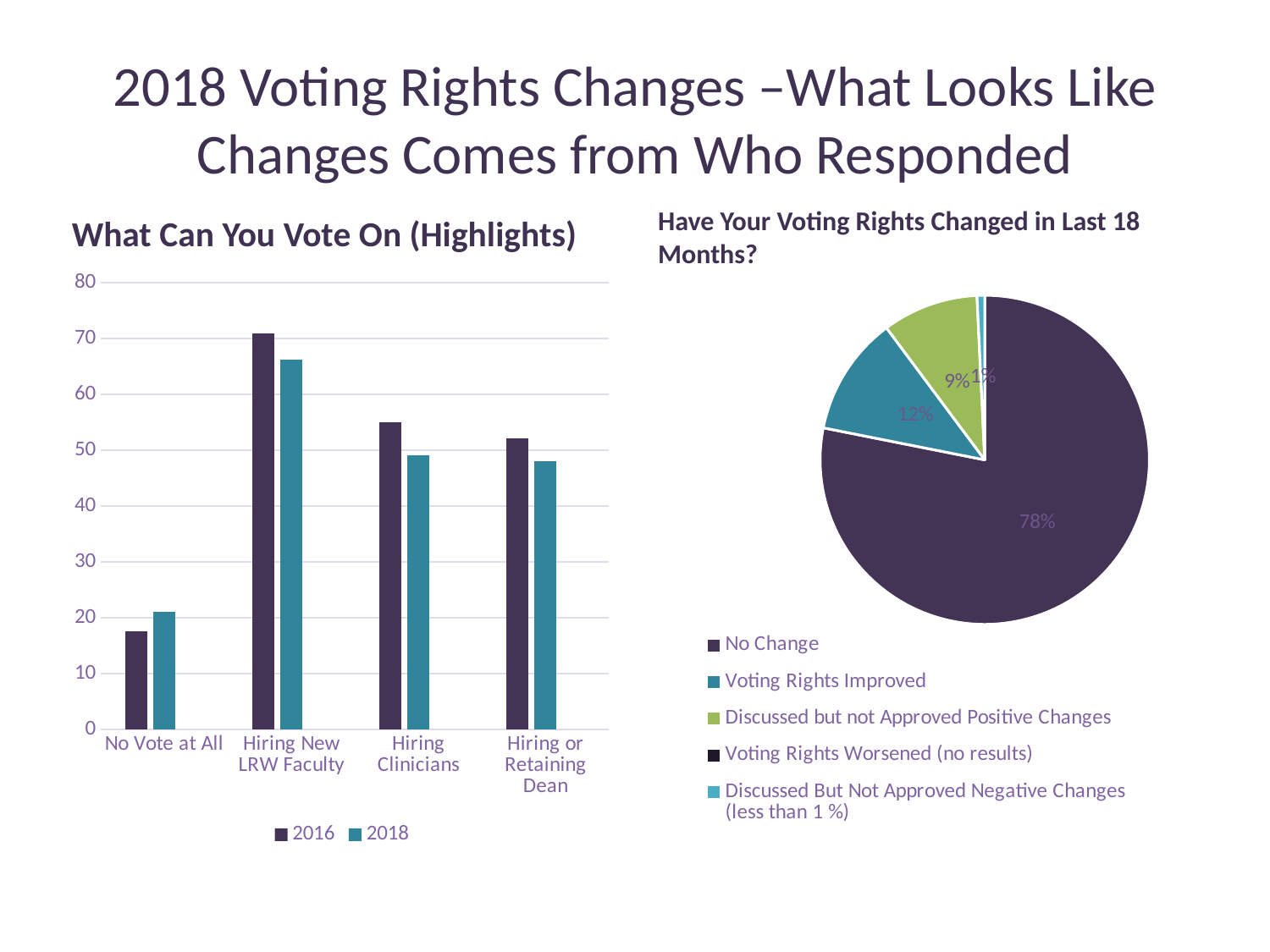
In the 'What Can You Vote On (Highlights)' chart, which category has the highest 2016 value? Hiring New LRW Faculty In the 'What Can You Vote On (Highlights)' chart, how many categories are shown on the x axis? 4 In the 'What Can You Vote On (Highlights)' chart, how many series does the legend list? 2 In the 'Have Your Voting Rights Changed in Last 18 Months?' chart, what share of the pie is Discussed but not Approved Positive Changes? 9% In the 'What Can You Vote On (Highlights)' chart, is the 2016 value for No Vote at All greater or less than 20? less In the 'What Can You Vote On (Highlights)' chart, which is larger for Hiring New LRW Faculty, the 2016 value or the 2018 value? 2016 In the 'What Can You Vote On (Highlights)' chart, is the 2016 value for Hiring Clinicians greater or less than 50? greater In the 'Have Your Voting Rights Changed in Last 18 Months?' chart, what share of the pie is No Change? 78% In the 'What Can You Vote On (Highlights)' chart, which category has the lowest 2018 value? No Vote at All In the 'Have Your Voting Rights Changed in Last 18 Months?' chart, what share of the pie is Voting Rights Improved? 12% In the 'Have Your Voting Rights Changed in Last 18 Months?' chart, how many entries does the legend list? 5 In the 'What Can You Vote On (Highlights)' chart, what kind of chart is it? bar chart